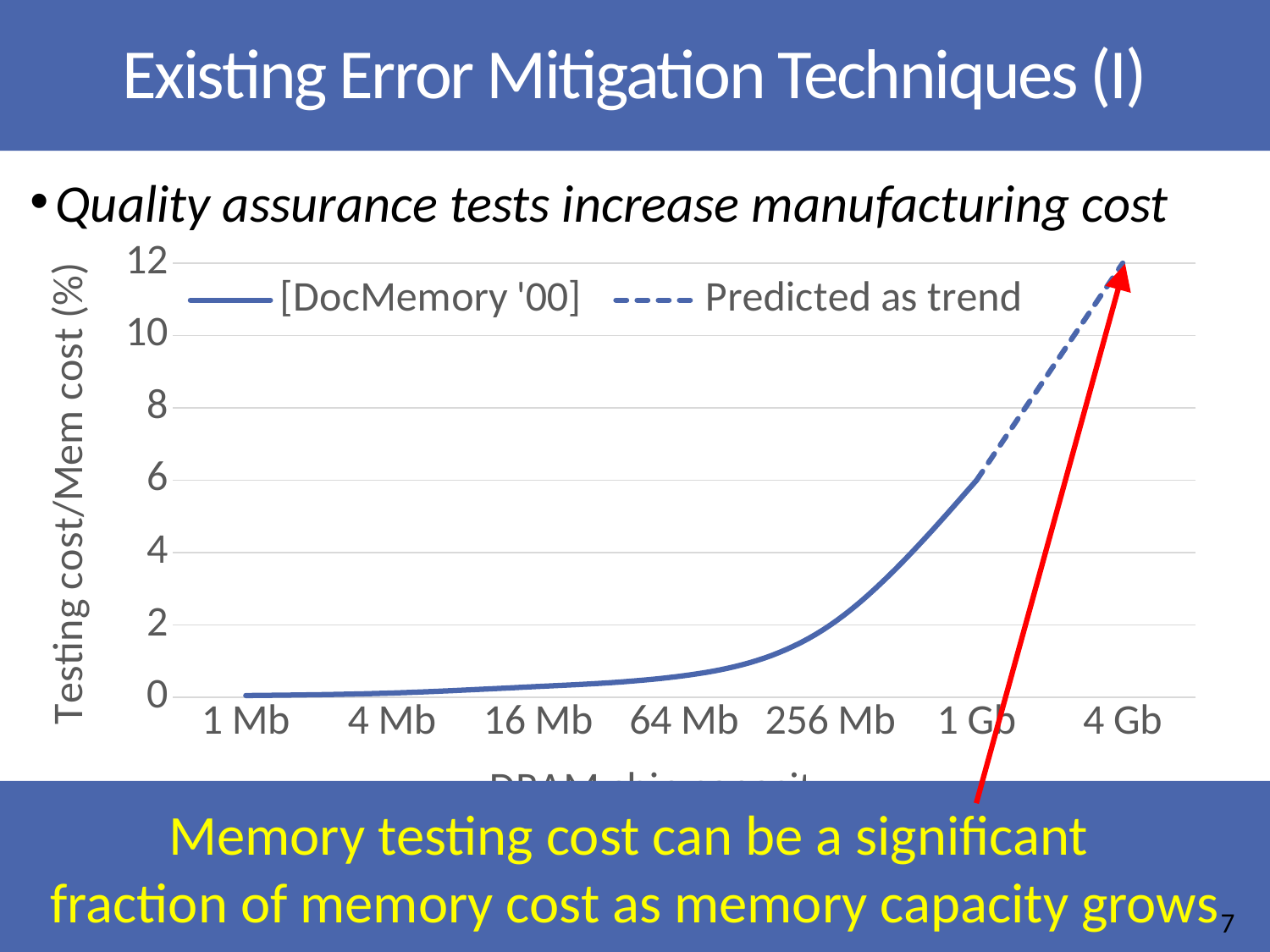
Do the values rise or fall as DRAM chip capacity increases along the x axis? rise What kind of chart is shown on the slide? line chart Is the value for 4 Gb greater or less than 10? greater Is the value for 1 Gb greater or less than 4? greater How many series does the chart legend list? 2 Which has the larger testing cost/mem cost, 1 Gb or 256 Mb? 1 Gb What is the label of the y axis? Testing cost/Mem cost (%) How many DRAM chip capacity categories are shown on the x axis? 7 Is the value for 1 Gb greater or less than 8? less At which DRAM chip capacity is the testing cost/mem cost lowest? 1 Mb At which DRAM chip capacity is the testing cost/mem cost highest? 4 Gb